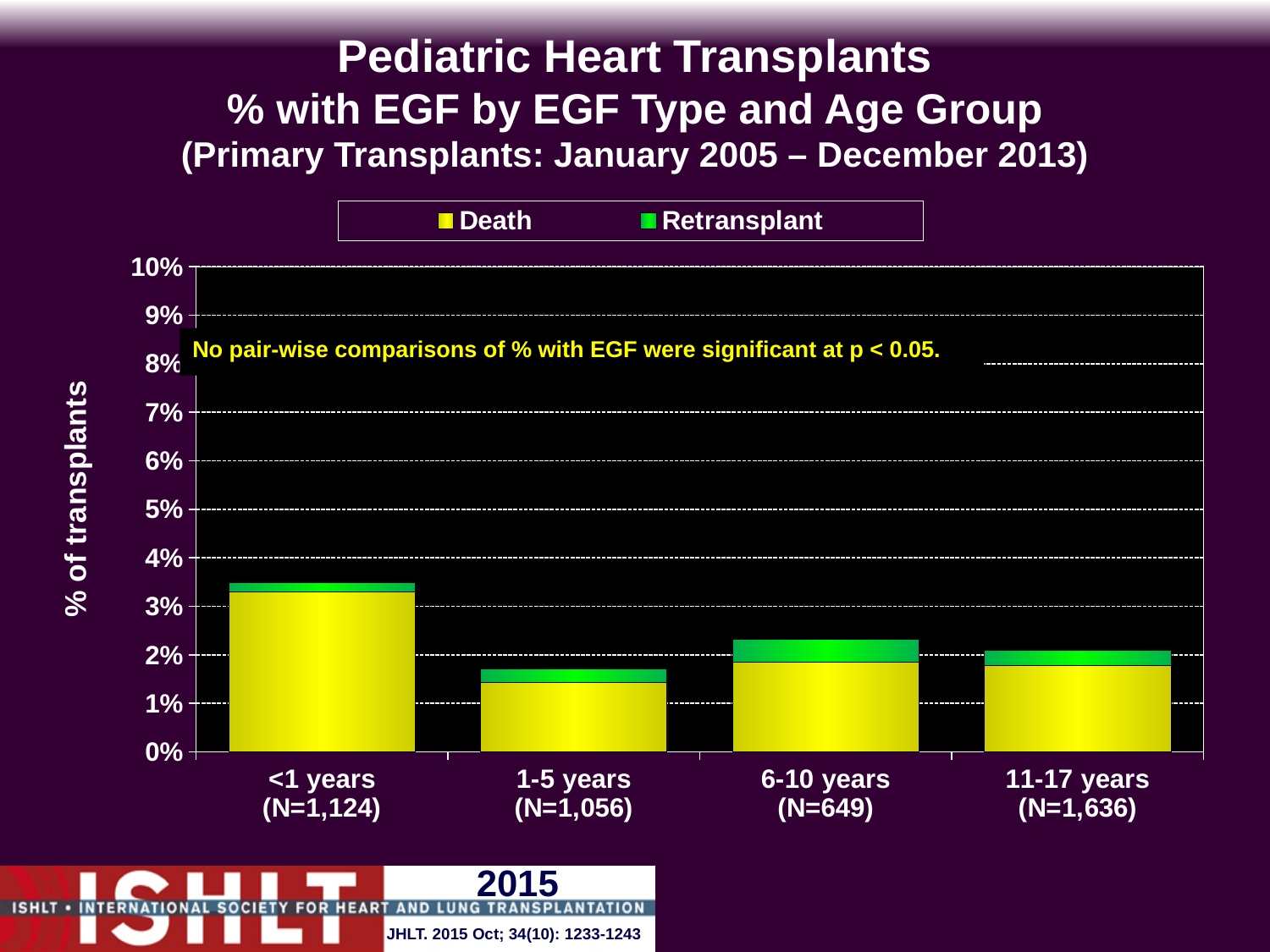
Is the total % with EGF for 6-10 years greater or less than 3%? less Which has a higher total % with EGF: <1 years or 6-10 years? <1 years Is the total % with EGF for <1 years greater or less than 3%? greater Is the total % with EGF for 1-5 years greater or less than 2%? less What are the two series named in the legend? Death and Retransplant Which age group has the lowest total % with EGF? 1-5 years What is the N shown for the 6-10 years age group? N=649 Which age group has the highest total % with EGF? <1 years How many age groups are shown on the x axis? 4 What kind of chart is shown on the slide? bar chart How many series does the legend list? 2